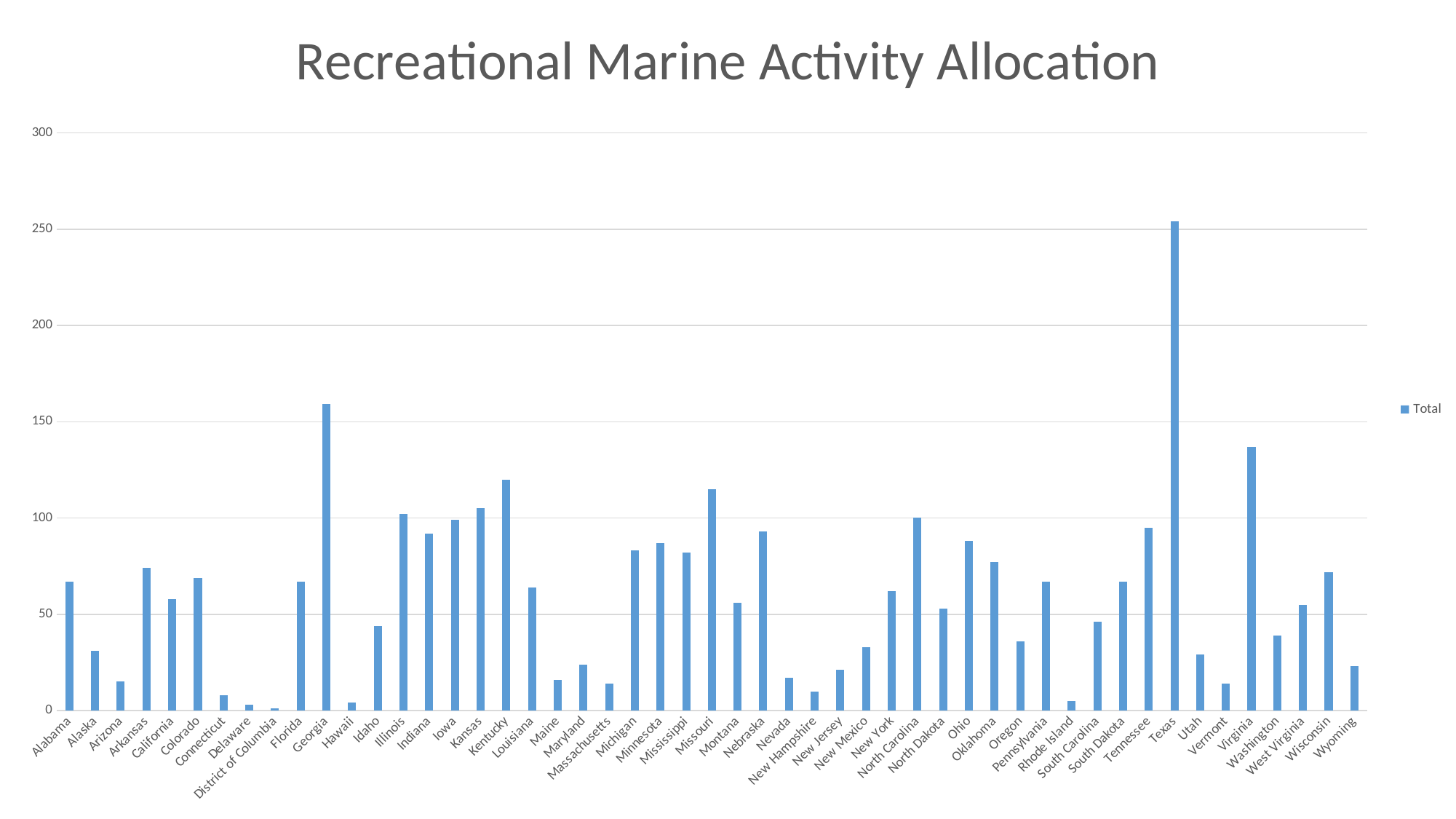
Is the value for Texas greater or less than 200? greater Is the value for Georgia greater or less than 150? greater What kind of chart is shown on the slide? bar chart Is the value for Kentucky greater or less than 100? greater Which category has the highest value? Texas How many series does the legend list? 1 How many states or categories are shown on the x axis? 51 What is the title of the chart? Recreational Marine Activity Allocation What is the name of the series shown in the legend? Total Which is larger, the value for Alabama or the value for Alaska? Alabama Which is larger, the value for Georgia or the value for Virginia? Georgia